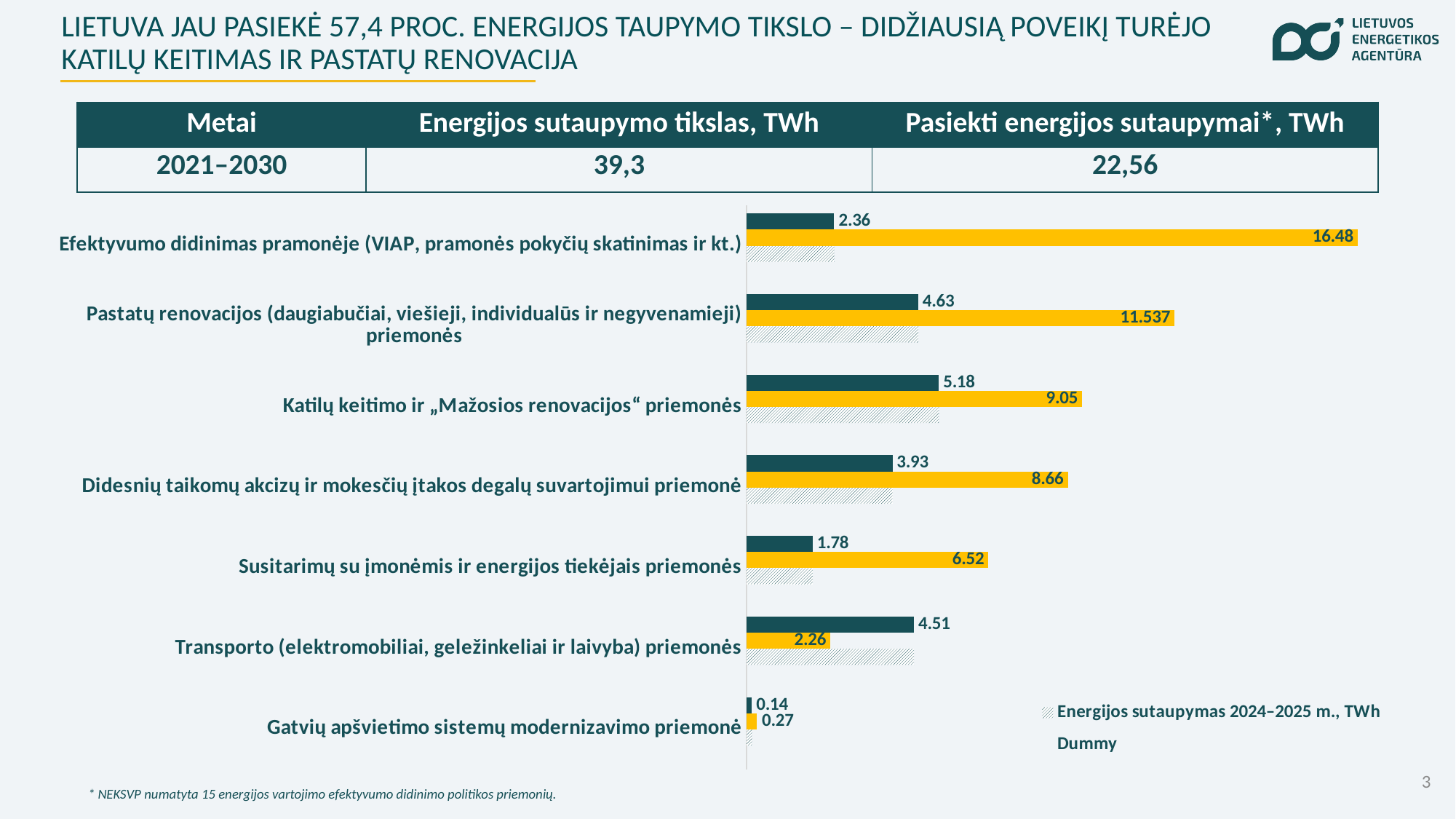
For "Transporto (elektromobiliai, geležinkeliai ir laivyba) priemonės", which is larger: the dark teal bar or the yellow bar? the dark teal bar What is the value of the dark teal bar for "Katilų keitimo ir „Mažosios renovacijos“ priemonės"? 5.18 How many categories are shown in the chart? 7 Which category has the highest yellow bar value? Efektyvumo didinimas pramonėje (VIAP, pramonės pokyčių skatinimas ir kt.) According to the table above the chart, what is the energy saving target (Energijos sutaupymo tikslas) in TWh for 2021–2030? 39,3 What is the difference between the yellow bar and the dark teal bar for "Pastatų renovacijos (daugiabučiai, viešieji, individualūs ir negyvenamieji) priemonės"? 6.907 What type of chart is shown on the slide? bar chart What is the value of the yellow bar for "Efektyvumo didinimas pramonėje (VIAP, pramonės pokyčių skatinimas ir kt.)"? 16.48 What is the value of the yellow bar for "Susitarimų su įmonėmis ir energijos tiekėjais priemonės"? 6.52 Which category has the highest dark teal bar value? Katilų keitimo ir „Mažosios renovacijos“ priemonės What is the difference between the yellow bar values for "Katilų keitimo ir „Mažosios renovacijos“ priemonės" and "Didesnių taikomų akcizų ir mokesčių įtakos degalų suvartojimui priemonė"? 0.39 Which category has the lowest dark teal bar value? Gatvių apšvietimo sistemų modernizavimo priemonė